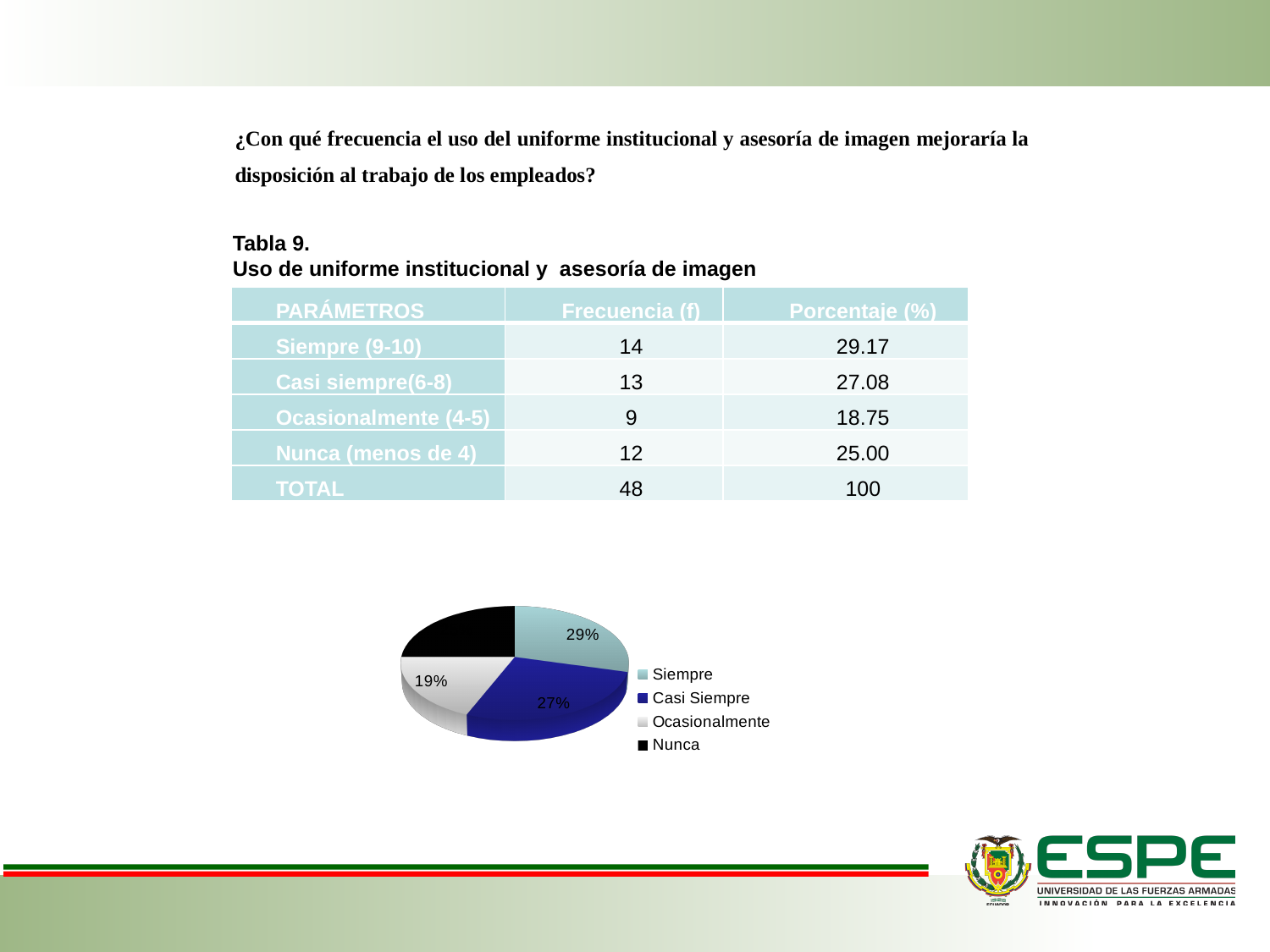
What percentage does the pie chart show for Casi Siempre? 27% What type of chart is shown on the slide? pie chart What colour is the Nunca slice in the pie chart? black Which slice is larger in the pie chart, Siempre or Ocasionalmente? Siempre What percentage does the pie chart show for Ocasionalmente? 19% How many slices does the pie chart have? 4 What percentage does the pie chart show for Siempre? 29% Which category has the largest slice in the pie chart? Siempre By how many percentage points does the Siempre slice exceed the Casi Siempre slice? 2 Which category has the smallest slice in the pie chart? Ocasionalmente By how many percentage points does the Casi Siempre slice exceed the Ocasionalmente slice? 8 How many entries does the pie chart's legend list? 4